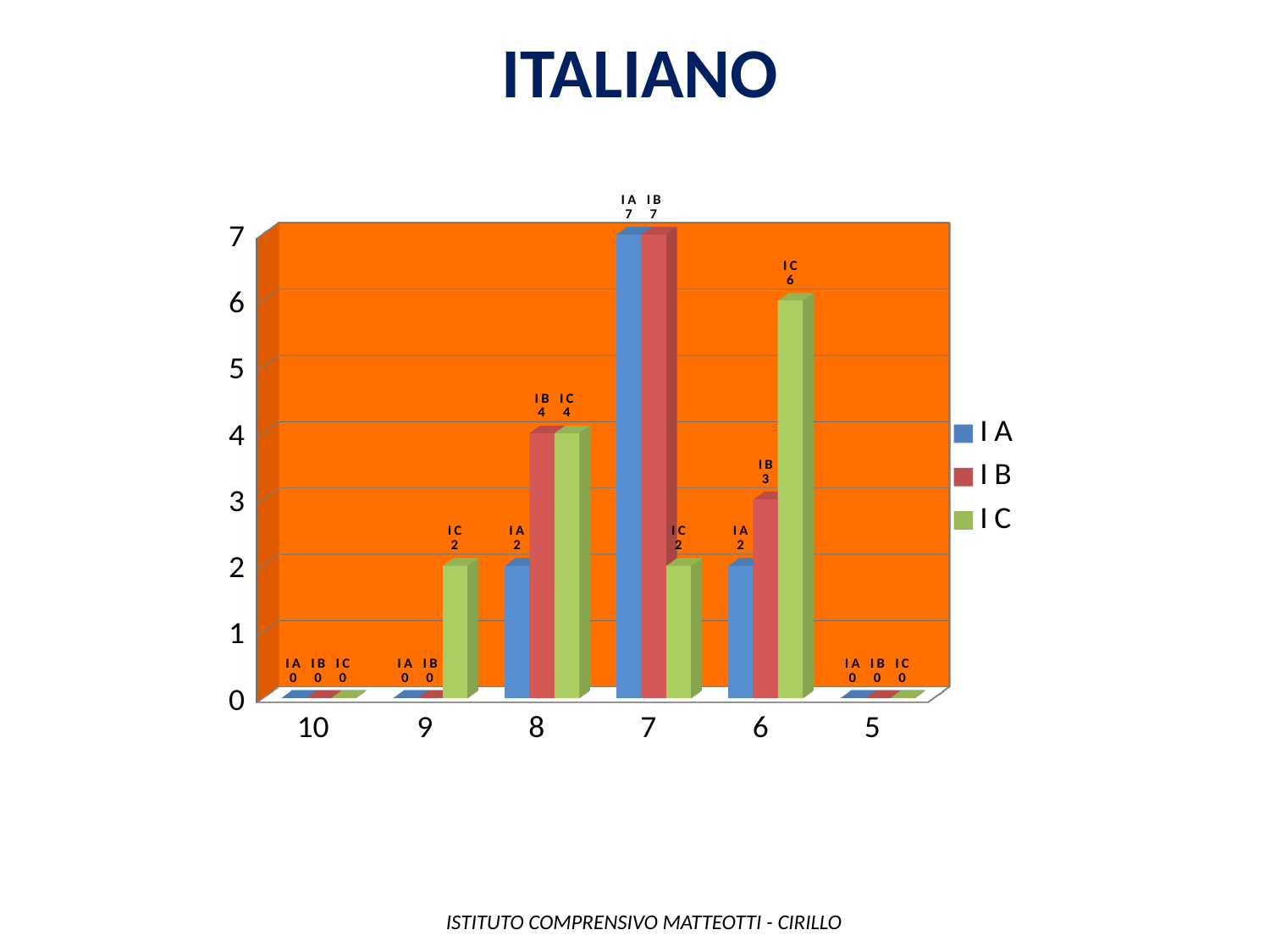
Which category has the highest value for I C? 6 What is the value for I B at category 8? 4 What is the value for I C at category 9? 2 What is the difference between the I C value and the I B value at category 6? 3 Which is larger at category 8: the value for I A or the value for I B? I B What is the value for I A at category 7? 7 What is the title of the chart? ITALIANO How many series does the legend list? 3 Which category has the highest value for I A? 7 How many categories are shown on the x axis? 6 What kind of chart is shown on the slide? Bar chart What is the value for I C at category 6? 6